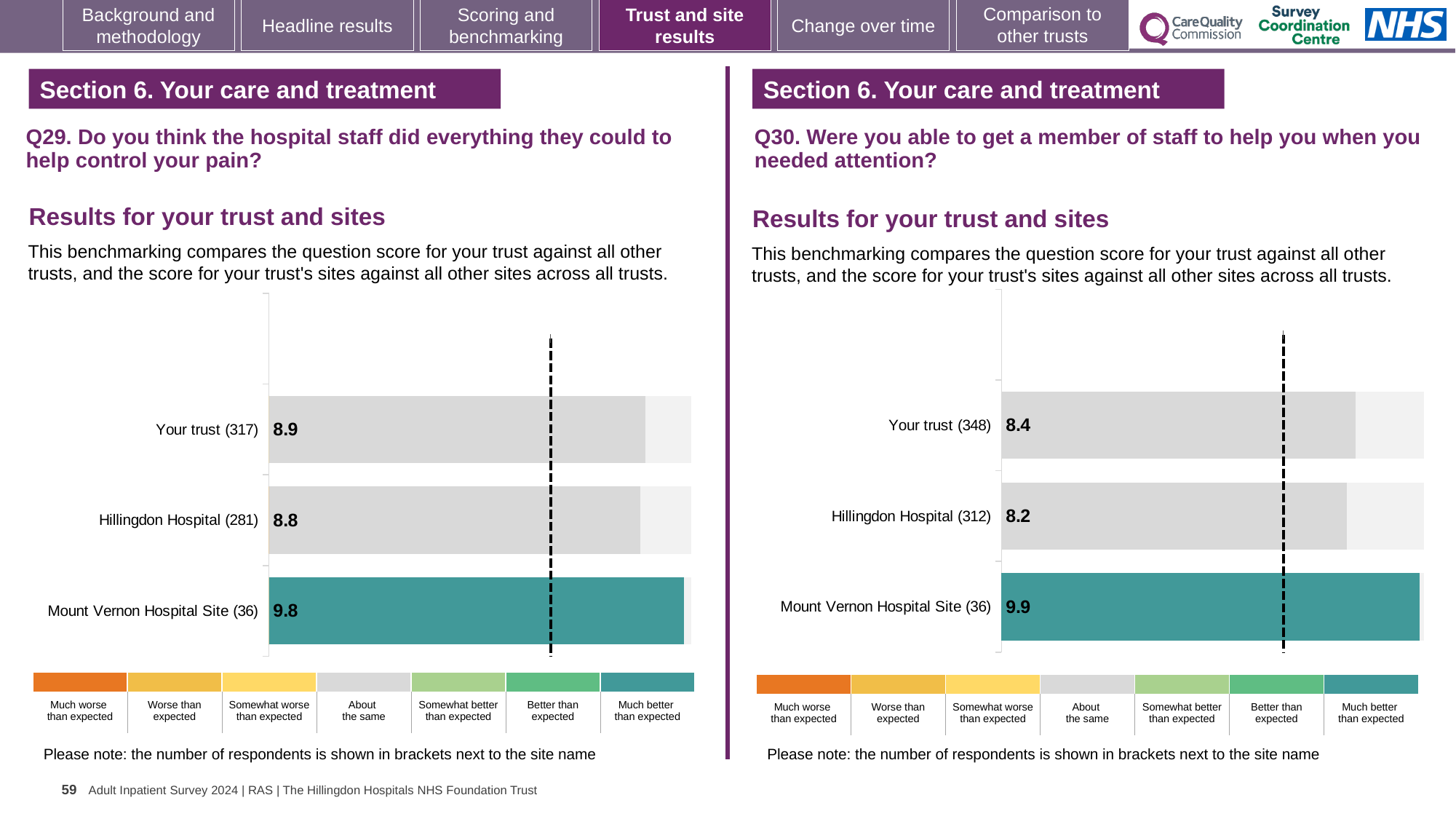
In the Q29 chart on the left, how many bars are plotted? 3 What type of chart is used on the left for Q29? Bar chart In the Q29 chart on the left, what is the score for Your trust (317)? 8.9 In the Q29 chart on the left, what is the score for Hillingdon Hospital (281)? 8.8 In the Q30 chart on the right, what is the score for Your trust (348)? 8.4 In the Q30 chart on the right, is the score for Your trust or for Hillingdon Hospital larger? Your trust In the Q30 chart on the right, what is the score for Mount Vernon Hospital Site (36)? 9.9 In the Q29 chart on the left, which site or trust has the highest score? Mount Vernon Hospital Site (36) In the Q30 chart on the right, what is the difference between the Your trust score and the Hillingdon Hospital score? 0.2 In the Q29 chart on the left, what is the difference between the Mount Vernon Hospital Site score and the Hillingdon Hospital score? 1.0 In the Q30 chart on the right, which site or trust has the lowest score? Hillingdon Hospital (312) In the Q30 chart on the right, which benchmark category does the colour of the Mount Vernon Hospital Site bar correspond to in the legend? Much better than expected